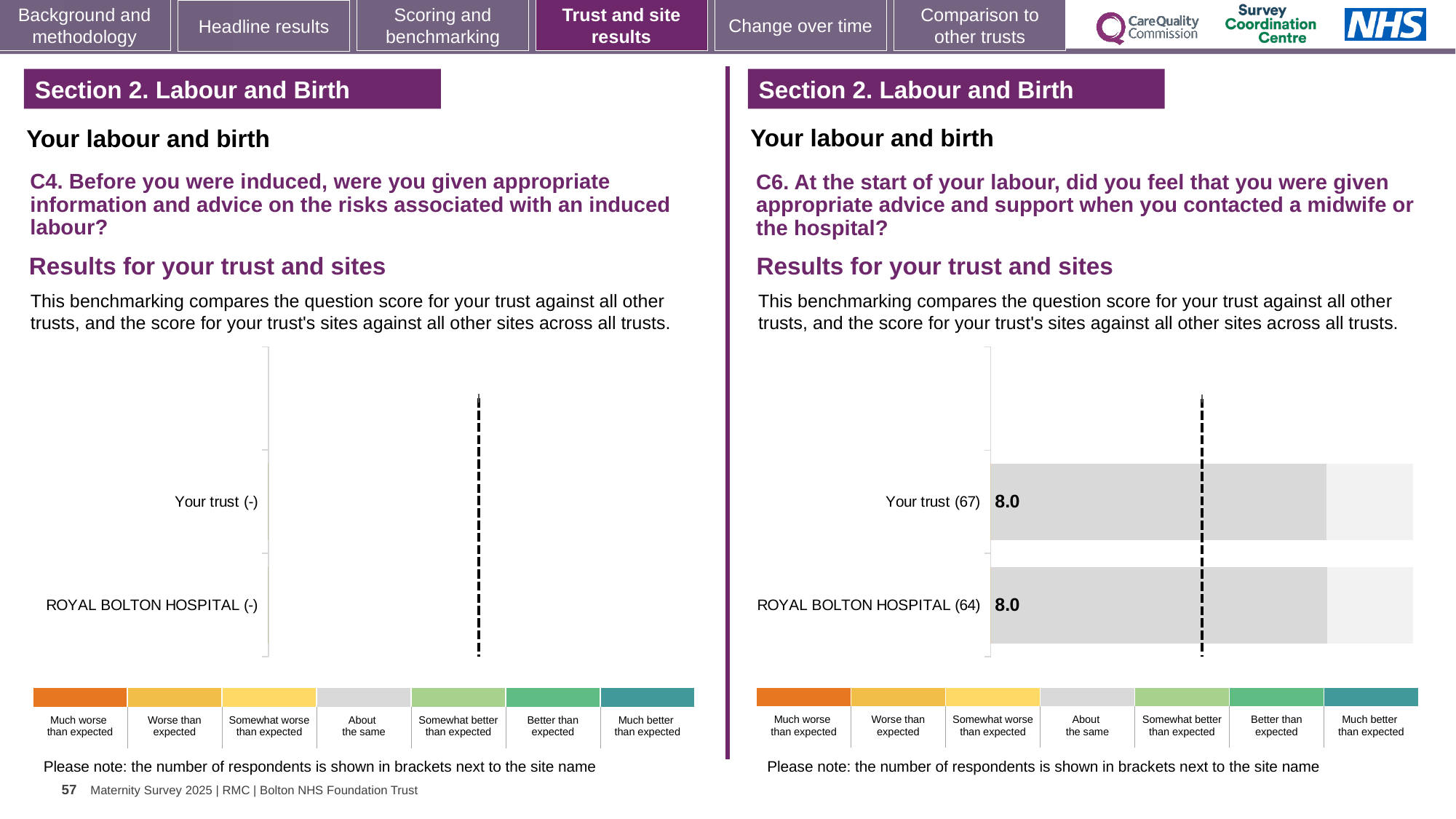
On the left-hand chart (C4), what is shown in brackets next to ROYAL BOLTON HOSPITAL? (-) What kind of chart is the right-hand chart (C6)? Bar chart On the left-hand chart (C4), how many categories are listed on the axis? 2 On the right-hand chart (C6), which has more respondents, Your trust or ROYAL BOLTON HOSPITAL? Your trust How many colour bands does the key below the right-hand chart (C6) show? 7 On the right-hand chart (C6), how many respondents are shown in brackets for Your trust? 67 On the right-hand chart (C6), what is the difference between the score for Your trust and the score for ROYAL BOLTON HOSPITAL? 0.0 On the right-hand chart (C6), what is the score for ROYAL BOLTON HOSPITAL? 8.0 On the right-hand chart (C6), how many categories are plotted? 2 On the right-hand chart (C6), how many respondents are shown in brackets for ROYAL BOLTON HOSPITAL? 64 On the right-hand chart (C6), what is the score for Your trust? 8.0